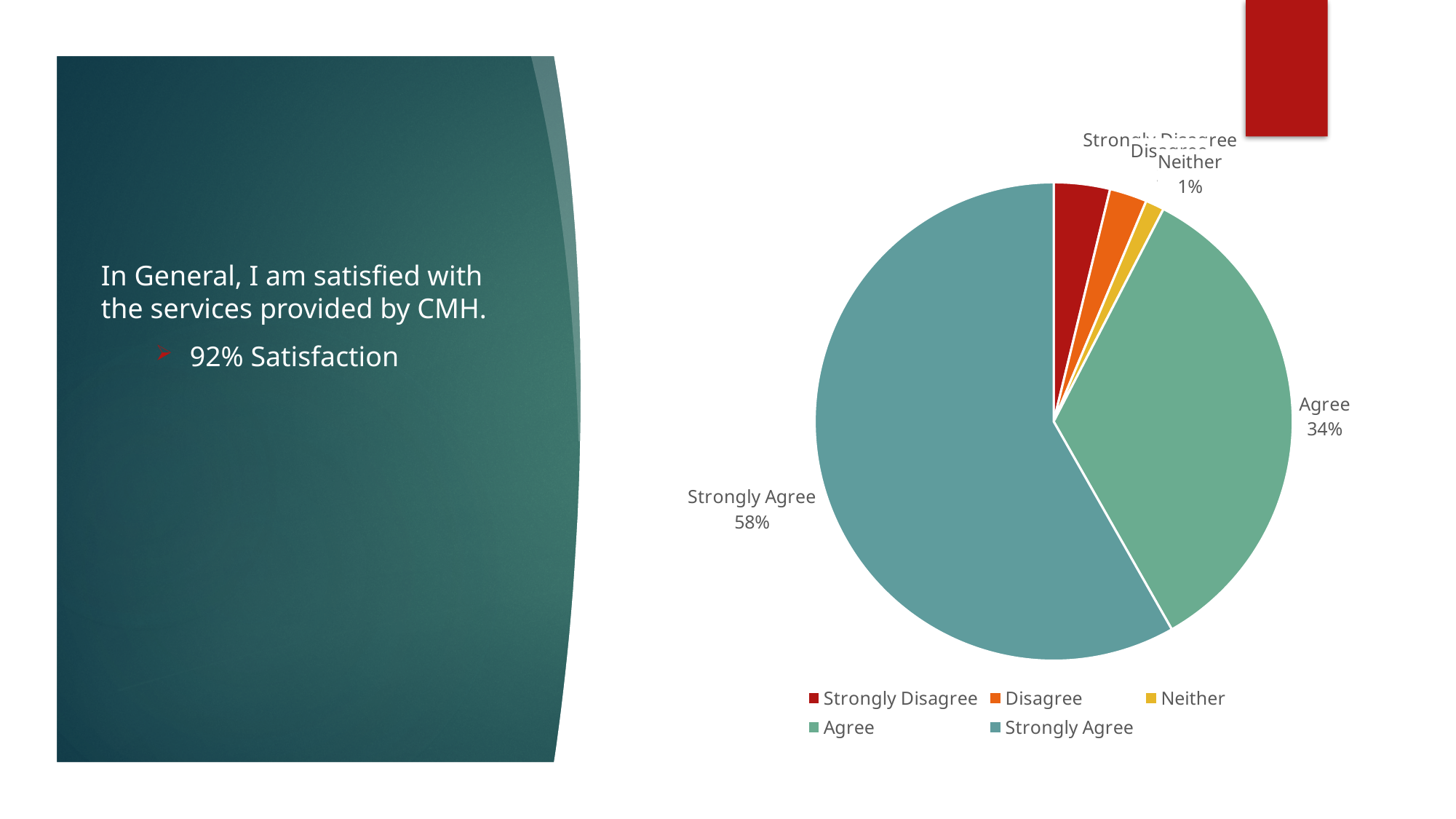
Which slice is larger, Agree or Strongly Agree? Strongly Agree Which category has the largest slice of the pie? Strongly Agree What is the combined share of the Agree and Strongly Agree slices? 92% How many entries does the chart legend list? 5 What share of the pie does the Agree slice represent? 34% Which category has the smallest slice of the pie? Neither What colour represents Strongly Disagree in the legend? Red How many slices does the pie chart have? 5 What percentage is shown for the Neither slice? 1% What type of chart is shown on the slide? Pie chart What share of the pie does the Strongly Agree slice represent? 58% What is the difference in percentage points between the Strongly Agree and Agree slices? 24